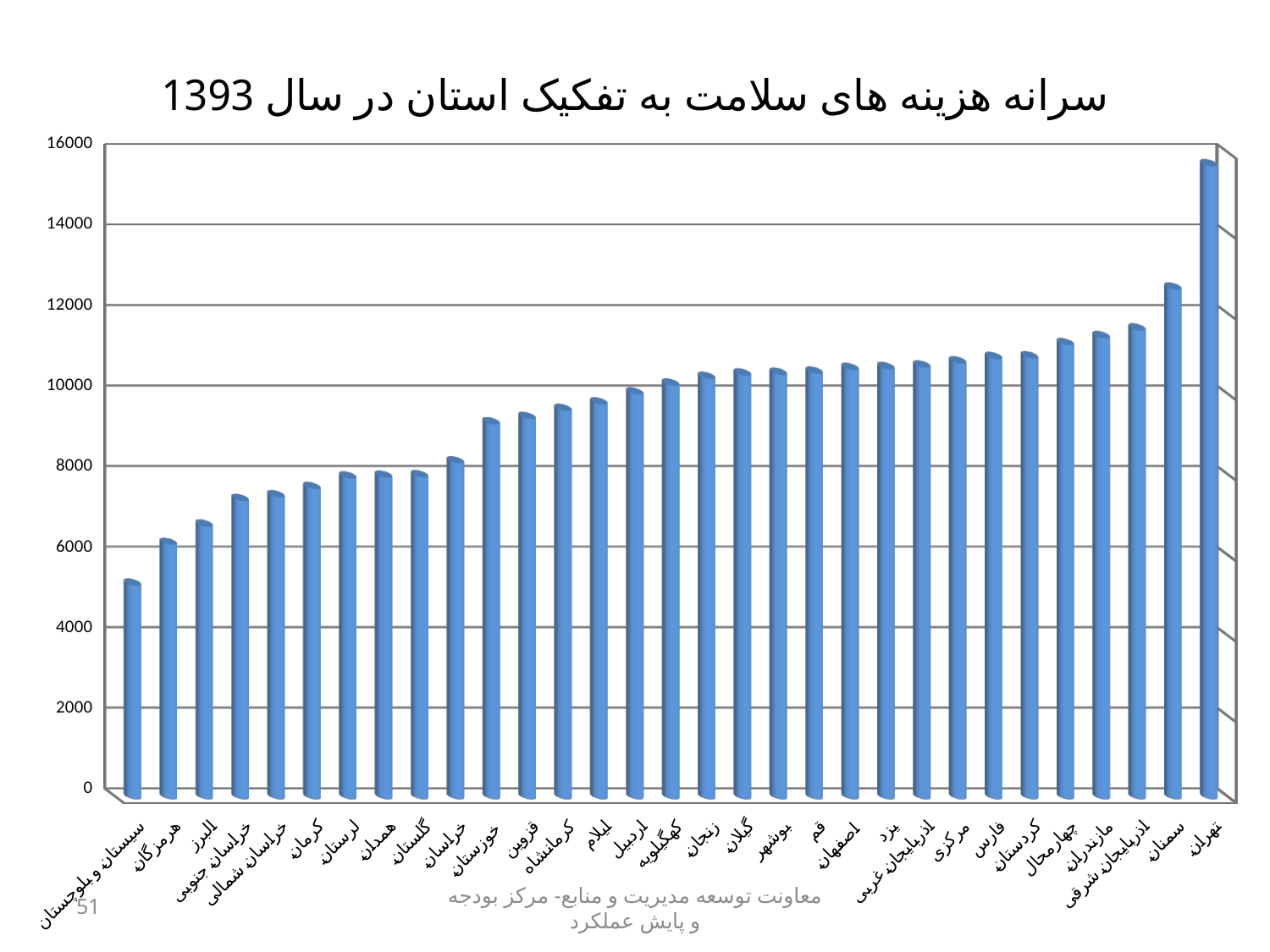
What type of chart is shown on the slide? bar chart Is the value for تهران greater or less than 14000? greater Which has a larger value, هرمزگان or مازندران? مازندران Is the value for سمنان greater or less than 12000? greater Which province has the highest per capita health expenditure in the chart? تهران How many provinces (bars) are shown in the chart? 31 Which province has the lowest per capita health expenditure in the chart? سیستان و بلوچستان What year is mentioned in the chart title? 1393 Is the value for خوزستان greater or less than 10000? less Do the bar values rise or fall moving from left to right along the x axis? rise Which has a larger value, البرز or سمنان? سمنان